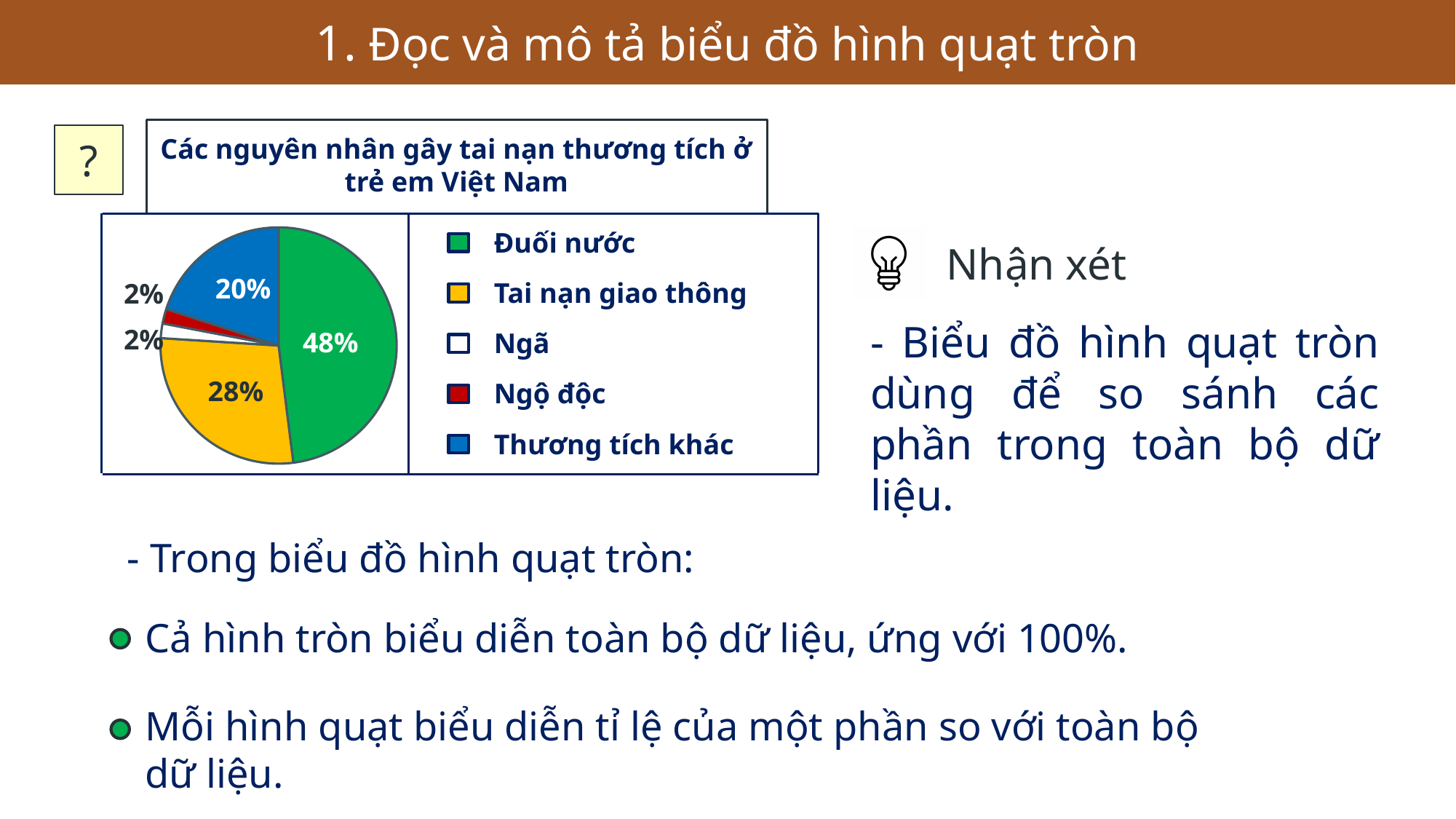
What kind of chart is shown on the slide? pie chart What is the difference in percentage points between Đuối nước and Tai nạn giao thông? 20 Which category has the largest slice of the pie chart? Đuối nước What percentage of the pie chart is Ngã? 2% How many categories does the pie chart legend list? 5 Which is larger, the slice for Tai nạn giao thông or the slice for Thương tích khác? Tai nạn giao thông What percentage of the pie chart is Ngộ độc? 2% What percentage of the pie chart is Thương tích khác? 20% What percentage of the pie chart is Tai nạn giao thông? 28% What percentage of the pie chart is Đuối nước? 48% What is the title of the pie chart? Các nguyên nhân gây tai nạn thương tích ở trẻ em Việt Nam What colour is the slice for Đuối nước in the pie chart? green